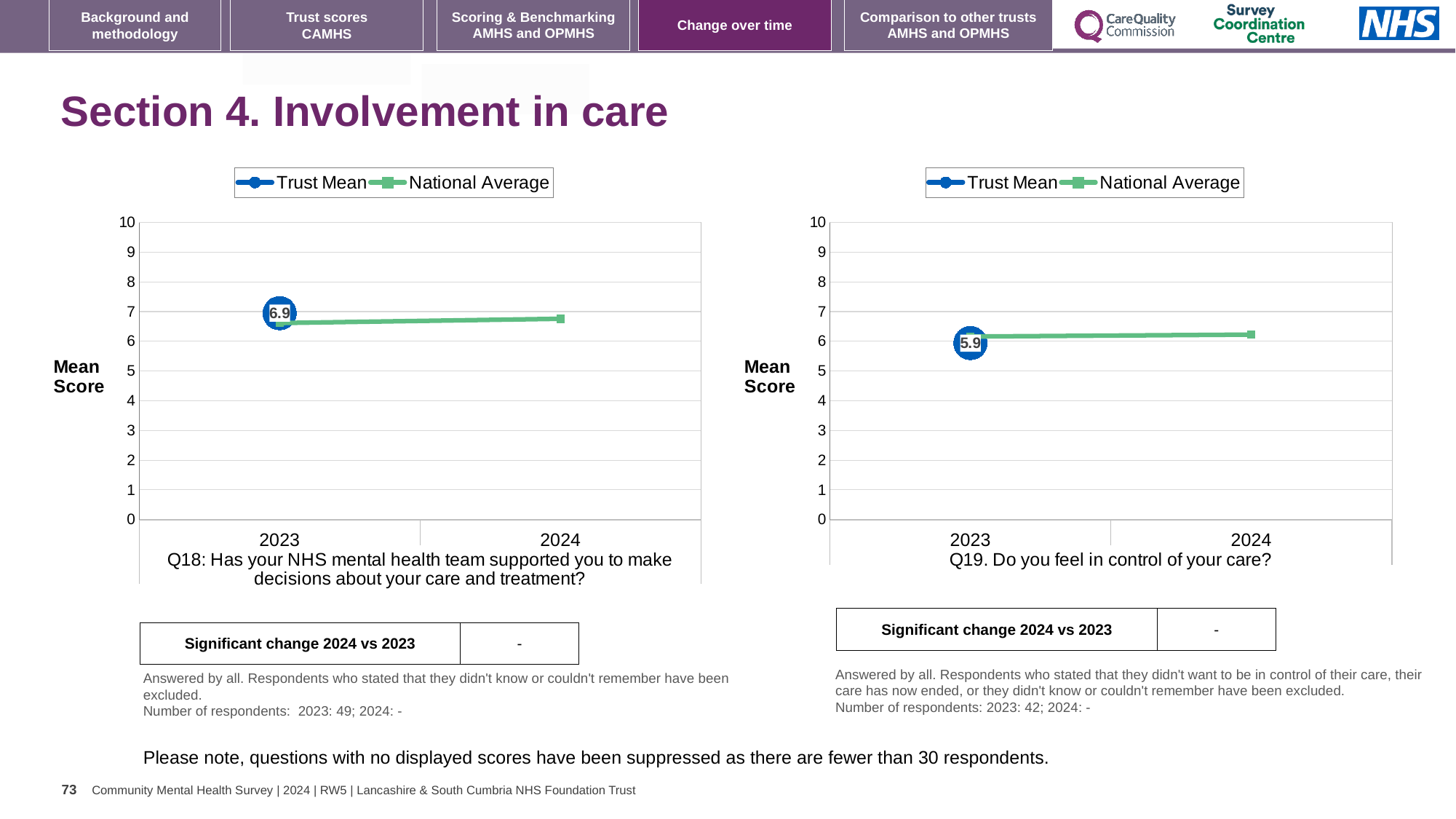
Which of the two charts has the higher Trust Mean score for 2023, Q18 or Q19? Q18 In the Q19 chart on the right, is the National Average value for 2024 greater or less than 7? less What type of chart is used for Q18 on the left? Line chart In the Q18 chart on the left, is the National Average value for 2024 greater or less than 7? less In the Q18 chart on the left, what is the Trust Mean score for 2023? 6.9 What are the two series named in the legend of the Q18 chart on the left? Trust Mean and National Average In the Q18 chart on the left, is the National Average value for 2024 greater or less than 6? greater How many years are shown on the x axis of the Q18 chart on the left? 2 In the Q19 chart on the right, what is the Trust Mean score for 2023? 5.9 How many series does the legend of the Q19 chart on the right list? 2 What is the label on the y axis of the Q19 chart on the right? Mean Score